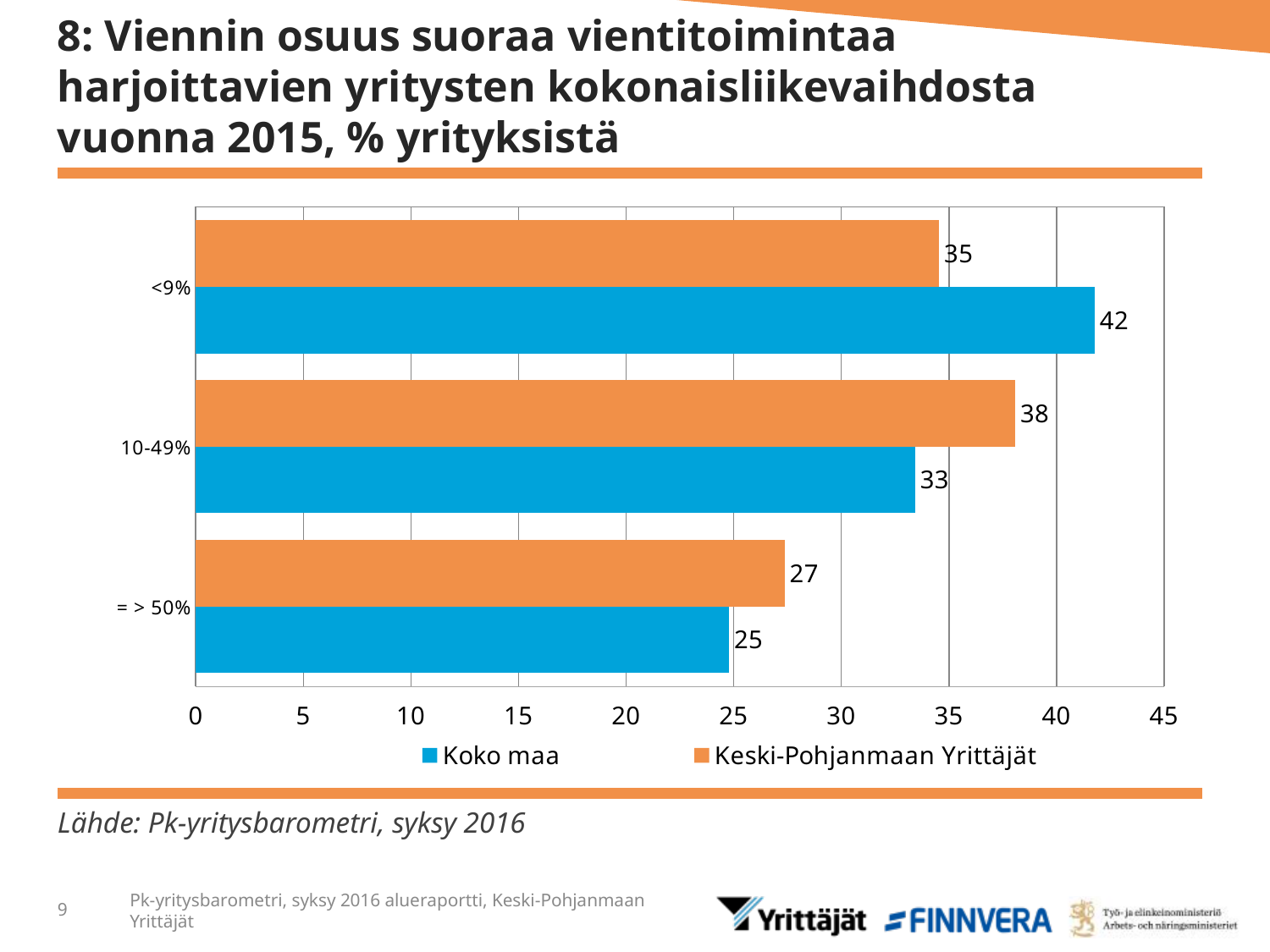
Is the value for Keski-Pohjanmaan Yrittäjät in the = > 50% category greater or less than 30? less What is the value for Koko maa in the = > 50% category? 25 Which category has the lowest value for Keski-Pohjanmaan Yrittäjät? = > 50% What is the value for Koko maa in the <9% category? 42 Which category has the highest value for Koko maa? <9% What is the value for Keski-Pohjanmaan Yrittäjät in the <9% category? 35 What is the value for Keski-Pohjanmaan Yrittäjät in the 10-49% category? 38 What is the difference between Koko maa and Keski-Pohjanmaan Yrittäjät in the <9% category? 7 How many series does the legend list? 2 How many categories are shown on the chart? 3 In the 10-49% category, which series has the larger value, Koko maa or Keski-Pohjanmaan Yrittäjät? Keski-Pohjanmaan Yrittäjät What kind of chart is shown on the slide? bar chart